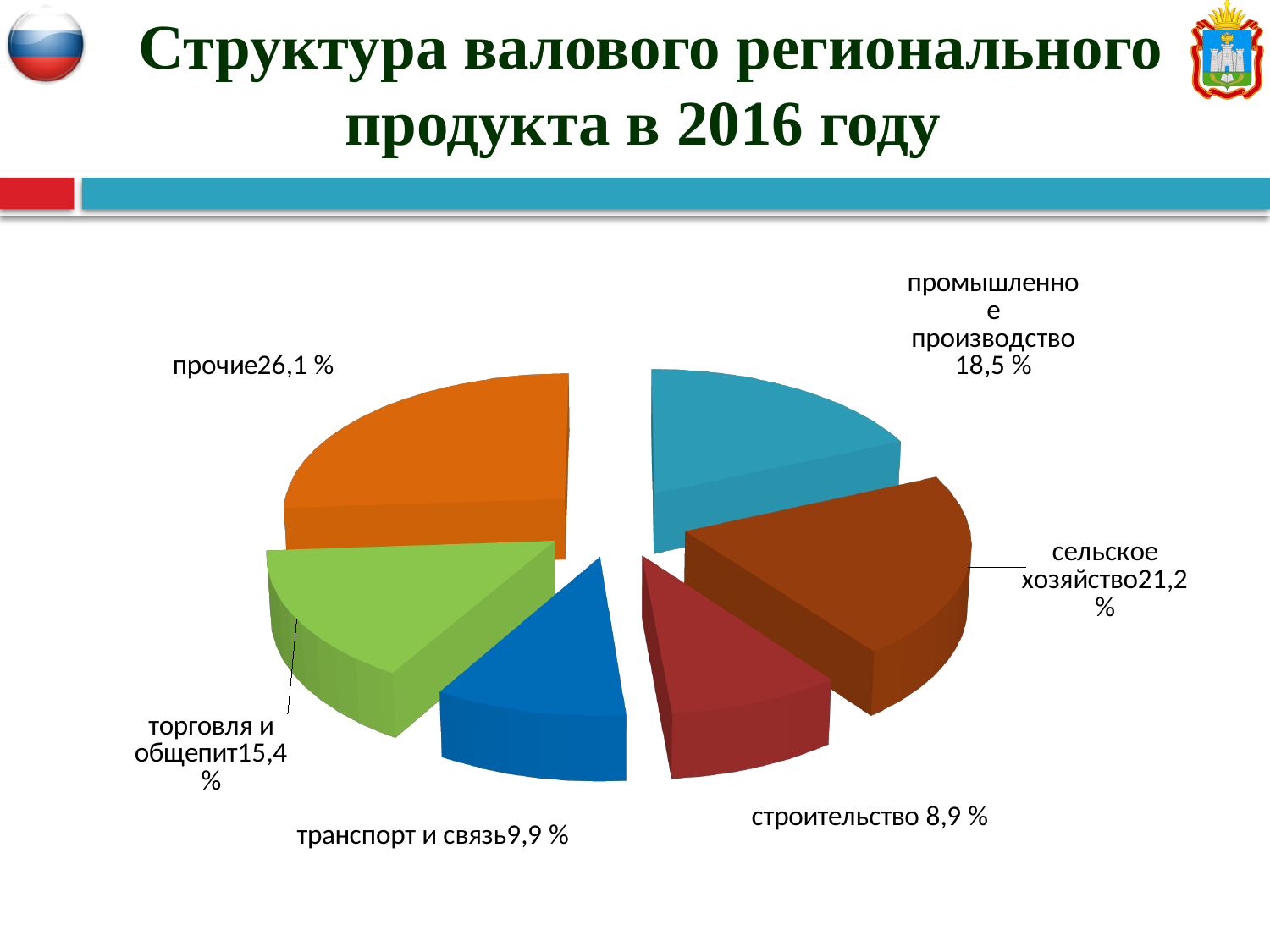
What kind of chart is shown on the slide? pie chart What is the difference between the shares of прочие and сельское хозяйство? 4,9 % What is the value for строительство? 8,9 % Which category has the largest share of the pie? прочие Which is larger, торговля и общепит or транспорт и связь? торговля и общепит How many slices does the pie chart have? 6 What share of the pie does торговля и общепит take? 15,4 % What is the title of the chart on the slide? Структура валового регионального продукта в 2016 году What is the value for сельское хозяйство? 21,2 % What is the value for транспорт и связь? 9,9 % Which category has the smallest share of the pie? строительство What is the value for промышленное производство? 18,5 %